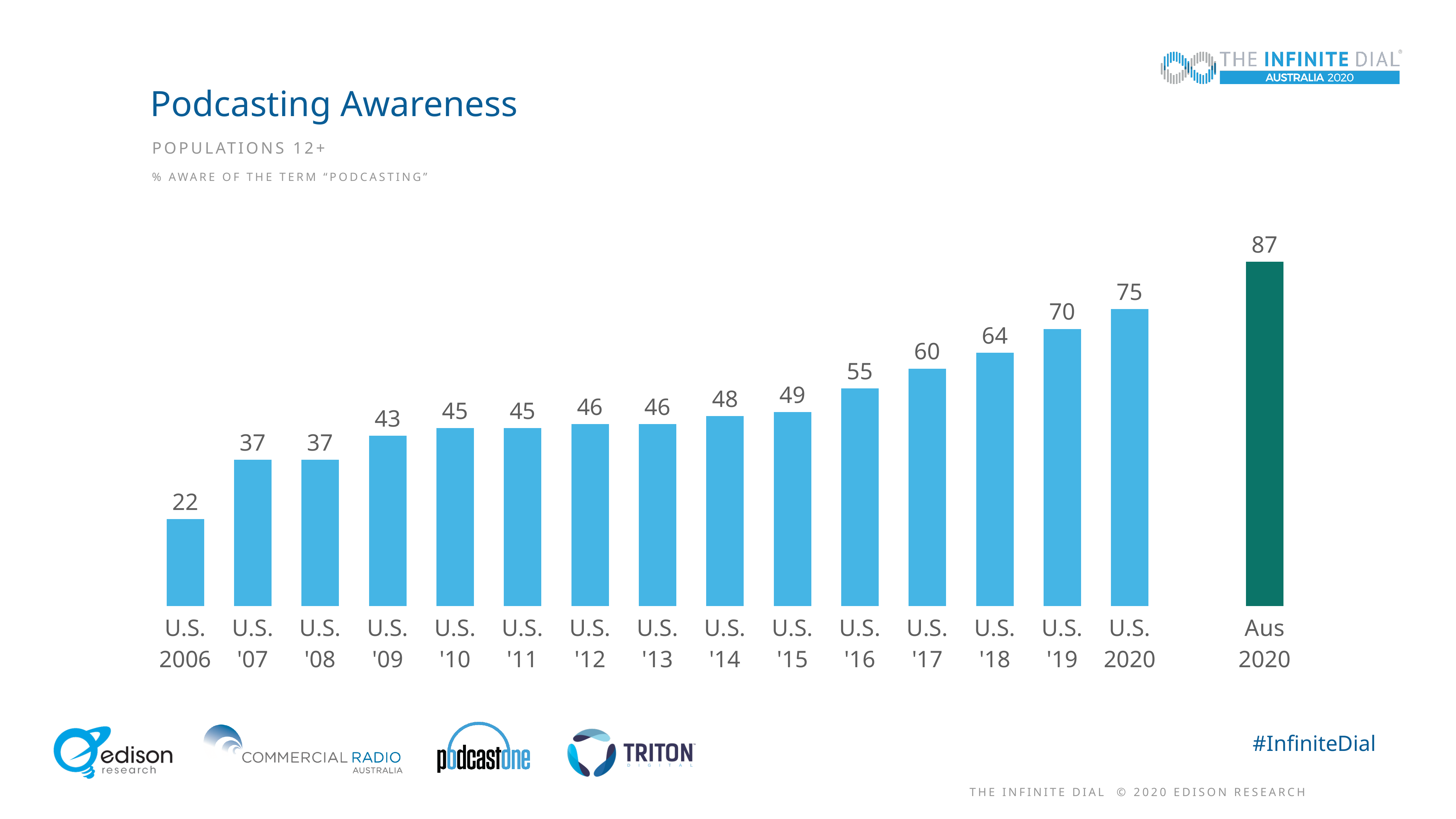
How many bars are shown in the chart? 16 What is the value for U.S. 2006? 22 Which category has the highest value? Aus 2020 What kind of chart is shown on the slide? bar chart What is the difference between the values for U.S. '19 and U.S. '18? 6 Which is larger, the value for U.S. '09 or the value for U.S. '08? U.S. '09 What is the value for U.S. '17? 60 Which category has the lowest value? U.S. 2006 What is the difference between the values for Aus 2020 and U.S. 2020? 12 What is the value for Aus 2020? 87 What is the title of the chart? Podcasting Awareness Do the U.S. values rise or fall from 2006 to 2020? rise